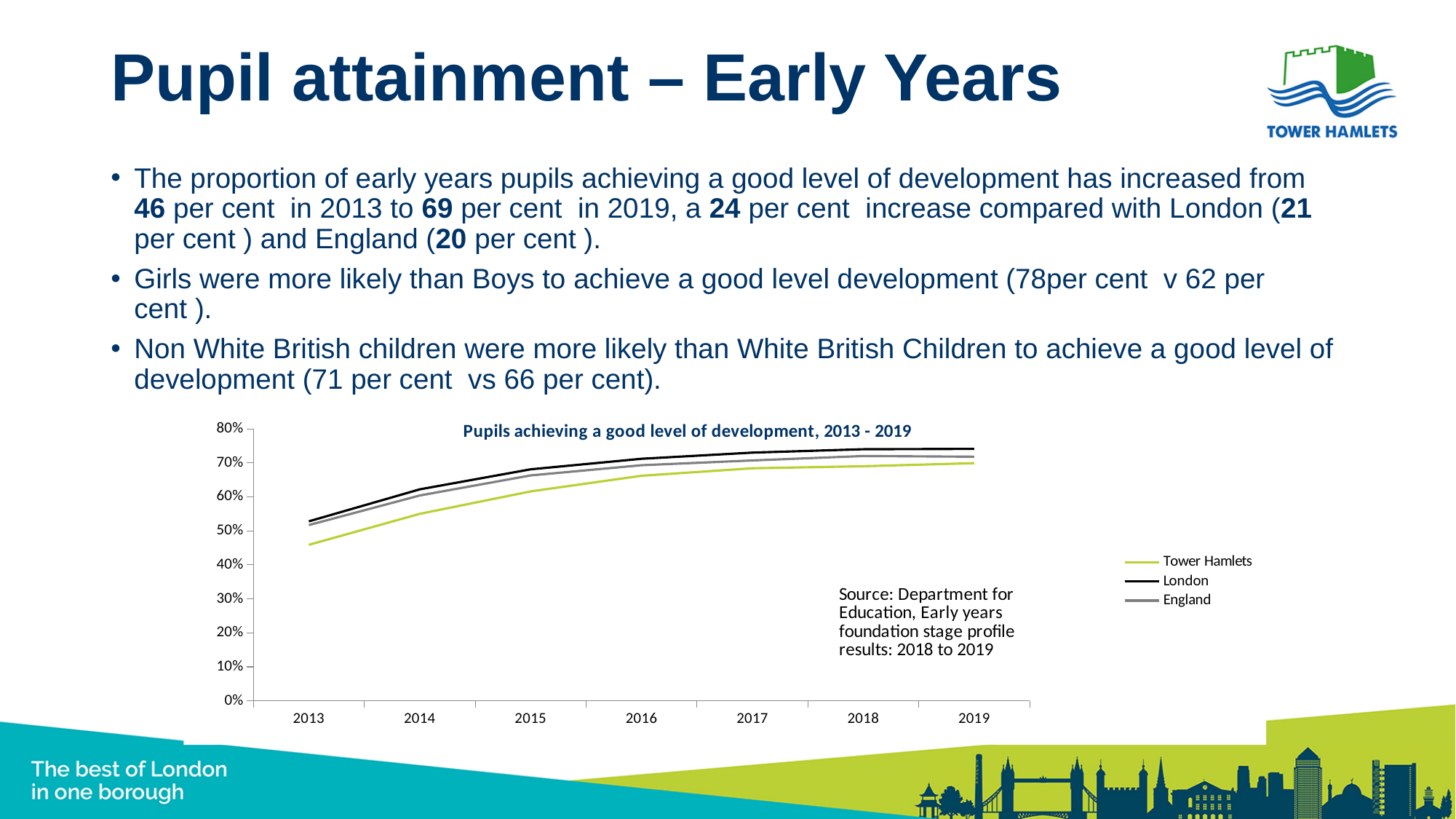
What is the title of the chart? Pupils achieving a good level of development, 2013 - 2019 Which series is drawn in green on the chart? Tower Hamlets Does the Tower Hamlets line rise or fall from 2013 to 2019? Rises Is the value for Tower Hamlets in 2013 greater or less than 50%? less Which series has the lowest value in 2013? Tower Hamlets In 2013, which is larger: the value for London or the value for Tower Hamlets? London How many years are plotted along the x axis of the chart? 7 Which series has the highest value in 2019? London How many series does the chart legend list? 3 Is the value for Tower Hamlets in 2016 greater or less than 60%? greater Is the value for London in 2019 greater or less than 70%? greater What kind of chart is shown on the slide? Line chart